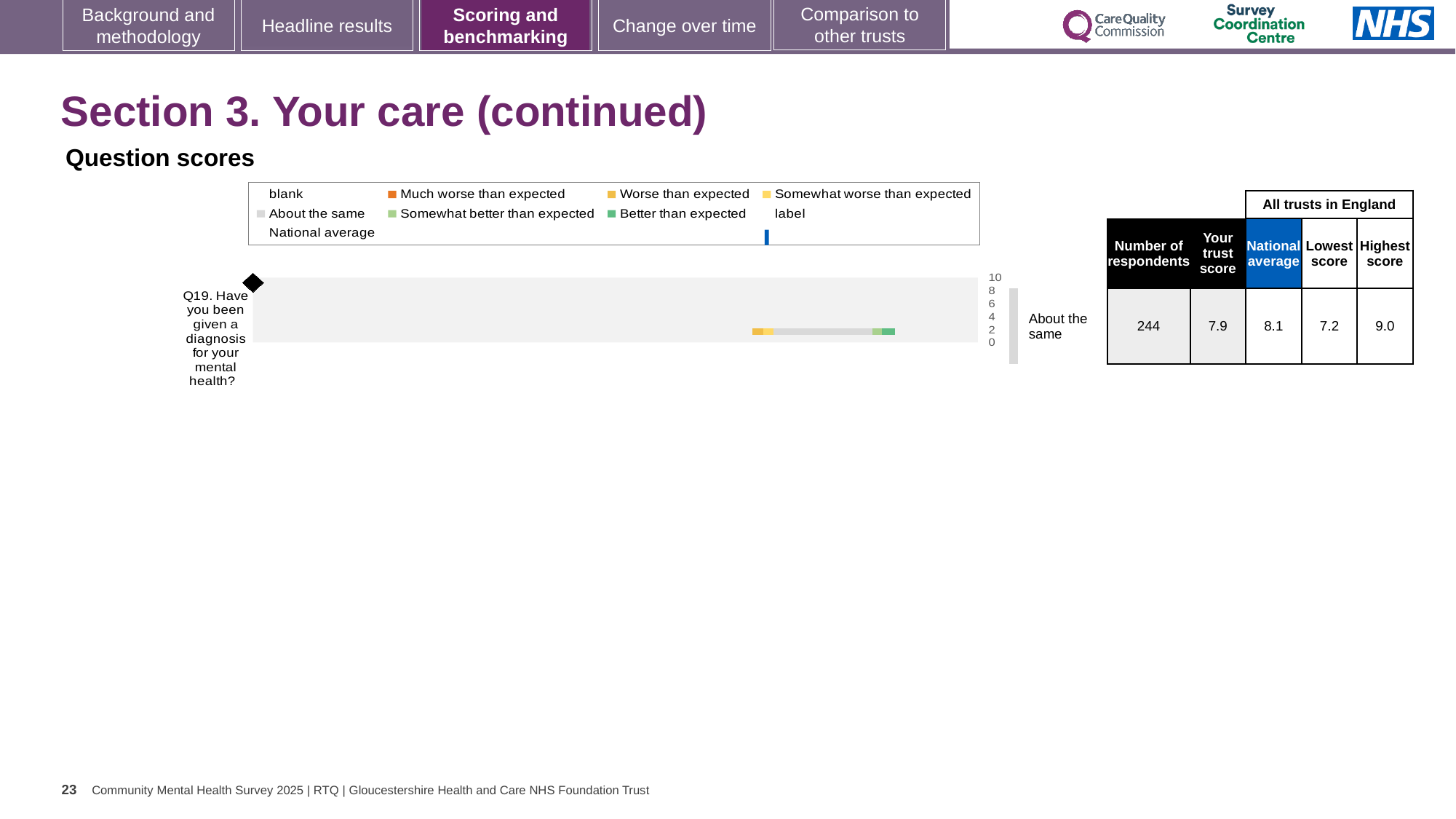
What is the difference between the Highest score and the Lowest score for Q19? 1.8 What is the 'Your trust score' for Q19 (Have you been given a diagnosis for your mental health?)? 7.9 By how much does the National average exceed the trust score for Q19? 0.2 What is the Lowest score among all trusts in England for Q19? 7.2 For Q19, which is larger: the trust score or the National average? National average What is the Highest score among all trusts in England for Q19? 9.0 How many questions are plotted in the Question scores chart? 1 What kind of chart is shown under 'Question scores'? bar chart Which legend entry is shown with the dark orange marker? Much worse than expected What benchmark category is shown next to the Q19 bar? About the same What is the National average score for Q19? 8.1 How many respondents answered Q19? 244